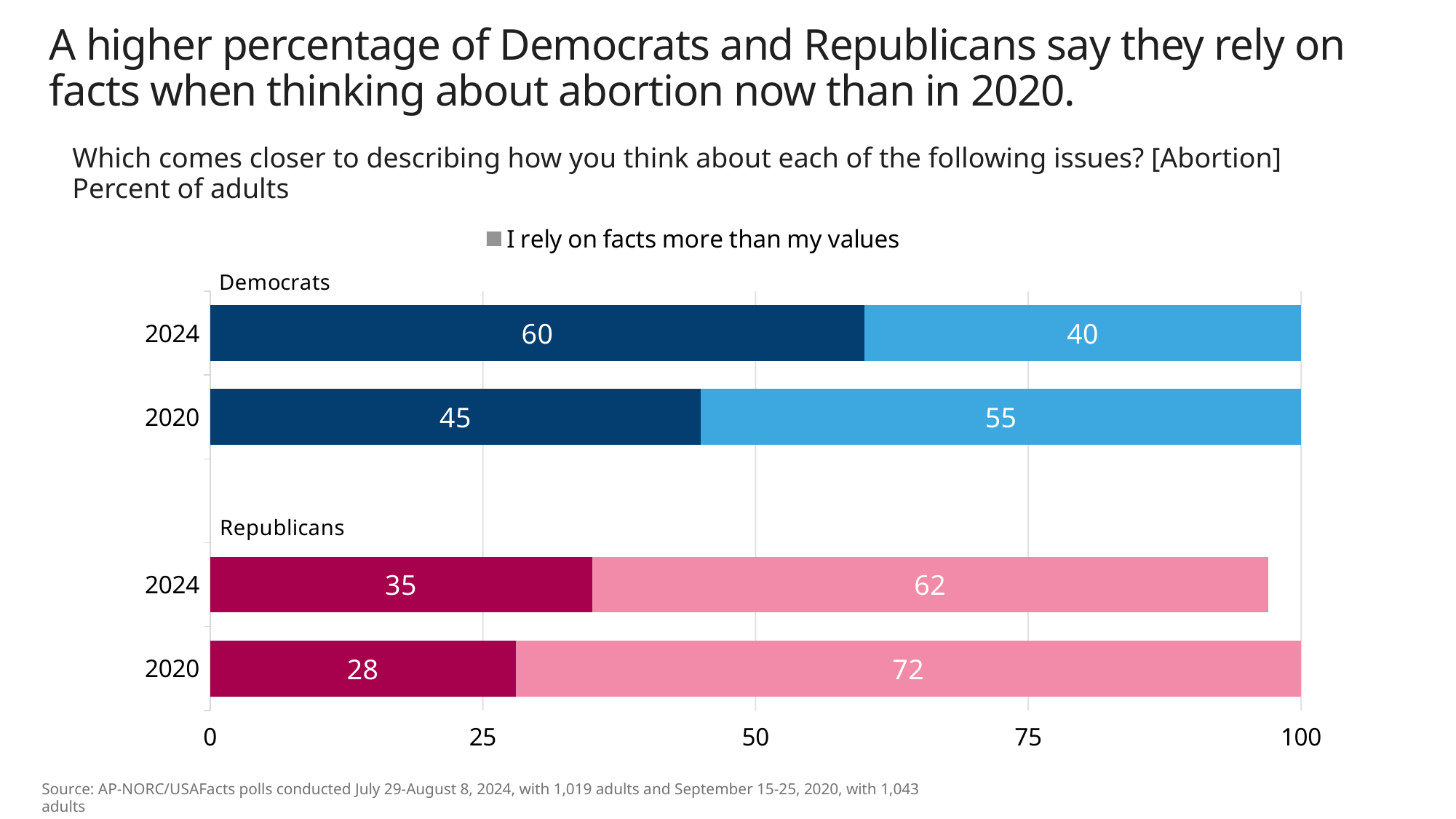
What kind of chart is shown on the slide? Stacked bar chart What is the value of the dark blue segment of the Democrats 2024 bar? 60 What is the total of the two labelled segments in the Republicans 2024 bar? 97 What is the value of the light blue segment of the Democrats 2020 bar? 55 What is the value of the light pink segment of the Republicans 2024 bar? 62 How many bars are plotted in the chart? 4 What is the value of the dark red segment of the Republicans 2020 bar? 28 What is the difference between the dark red segments of the Republicans 2024 and 2020 bars? 7 Which is larger: the dark segment of the Democrats 2020 bar or the dark segment of the Republicans 2024 bar? Democrats 2020 Which bar has the smallest dark (first) segment? Republicans 2020 By how much did the dark blue segment for Democrats increase from 2020 to 2024? 15 Which bar has the largest dark (first) segment? Democrats 2024